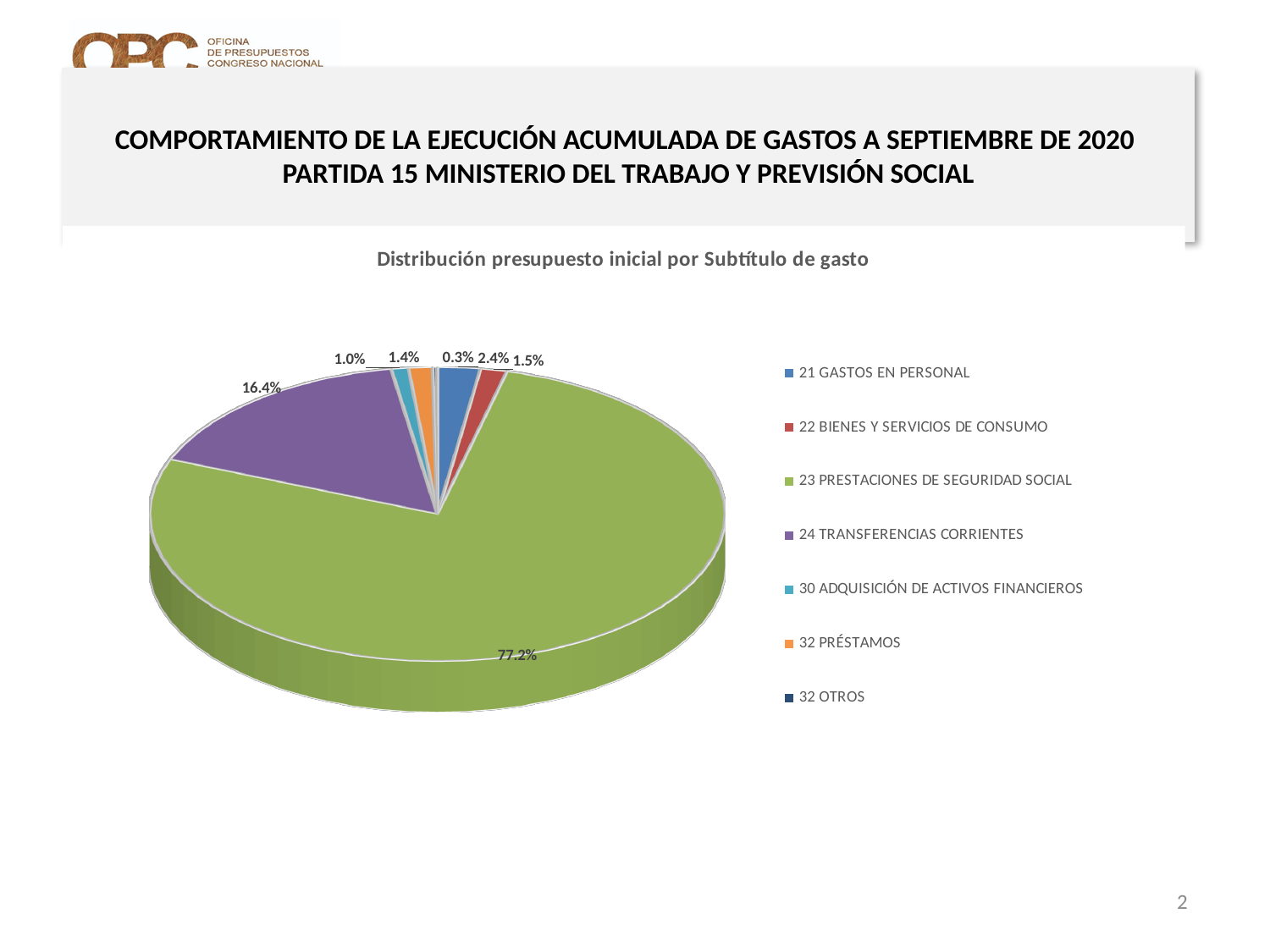
What is the difference in percentage points between 23 PRESTACIONES DE SEGURIDAD SOCIAL and 24 TRANSFERENCIAS CORRIENTES? 60.8 Which category has the smallest slice of the pie? 32 OTROS What share of the pie does 32 OTROS have? 0.3% What kind of chart is shown on the slide? pie chart Which category has the largest slice of the pie? 23 PRESTACIONES DE SEGURIDAD SOCIAL What share of the pie does 23 PRESTACIONES DE SEGURIDAD SOCIAL have? 77.2% How many categories does the legend list? 7 What is the title of the chart? Distribución presupuesto inicial por Subtítulo de gasto What share of the pie does 21 GASTOS EN PERSONAL have? 2.4% Which is larger, the slice for 24 TRANSFERENCIAS CORRIENTES or the slice for 21 GASTOS EN PERSONAL? 24 TRANSFERENCIAS CORRIENTES What colour is the slice for 24 TRANSFERENCIAS CORRIENTES? purple